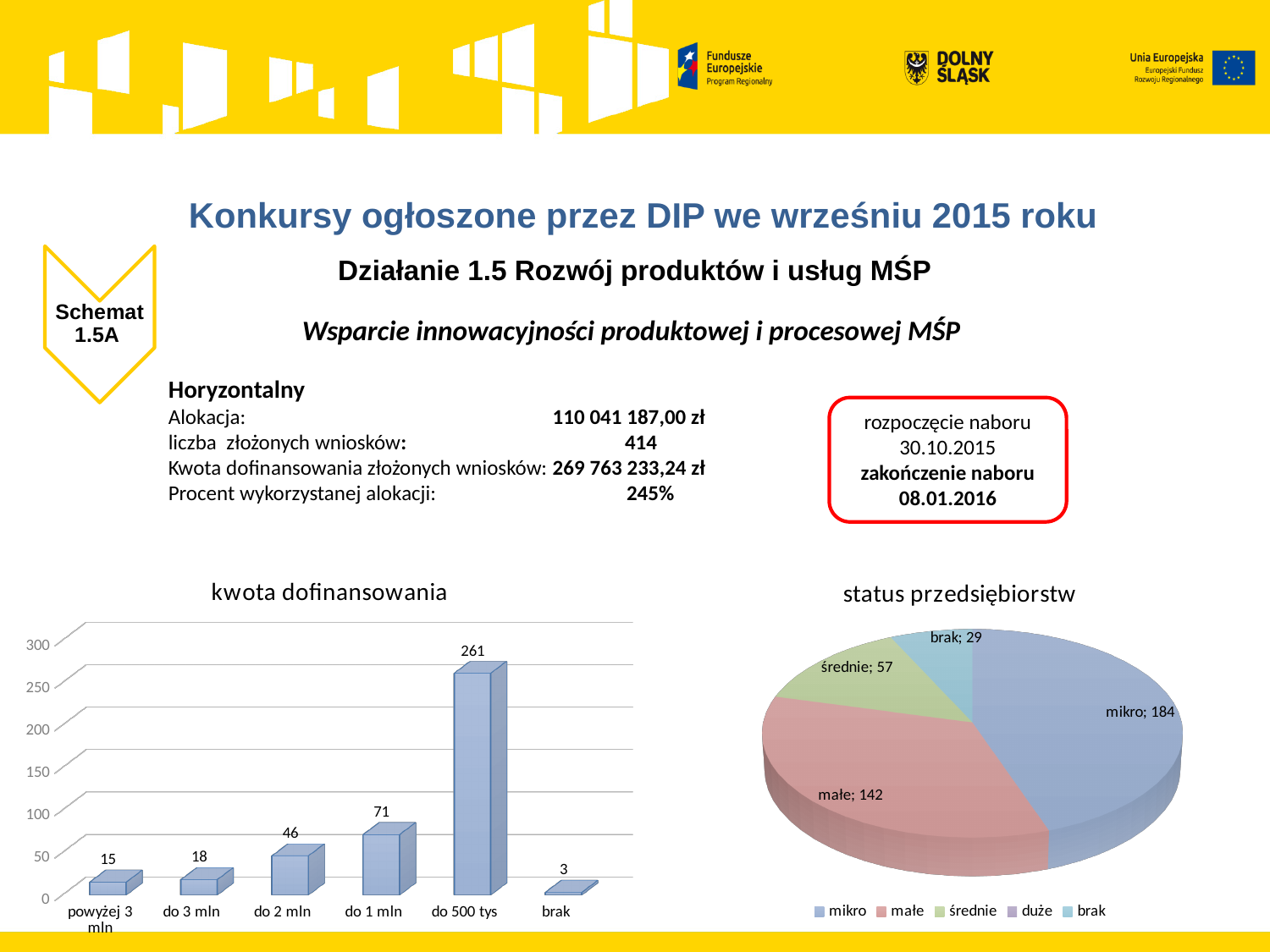
In the 'kwota dofinansowania' chart, which category has the lowest value? brak In the 'kwota dofinansowania' chart, what is the value for 'do 2 mln'? 46 In the 'kwota dofinansowania' chart, which category has the highest value? do 500 tys In the 'kwota dofinansowania' chart, what is the value for 'do 500 tys'? 261 In the 'kwota dofinansowania' chart, what is the difference between the values for 'do 1 mln' and 'do 3 mln'? 53 What type of chart is 'kwota dofinansowania'? bar chart How many categories are shown in the 'kwota dofinansowania' chart? 6 In the 'status przedsiębiorstw' chart, what is the difference between 'mikro' and 'średnie'? 127 In the 'status przedsiębiorstw' chart, what is the value for 'małe'? 142 In the 'kwota dofinansowania' chart, which is larger: 'powyżej 3 mln' or 'do 3 mln'? do 3 mln In the 'status przedsiębiorstw' chart, which category has the largest slice? mikro How many entries does the legend of the 'status przedsiębiorstw' chart list? 5